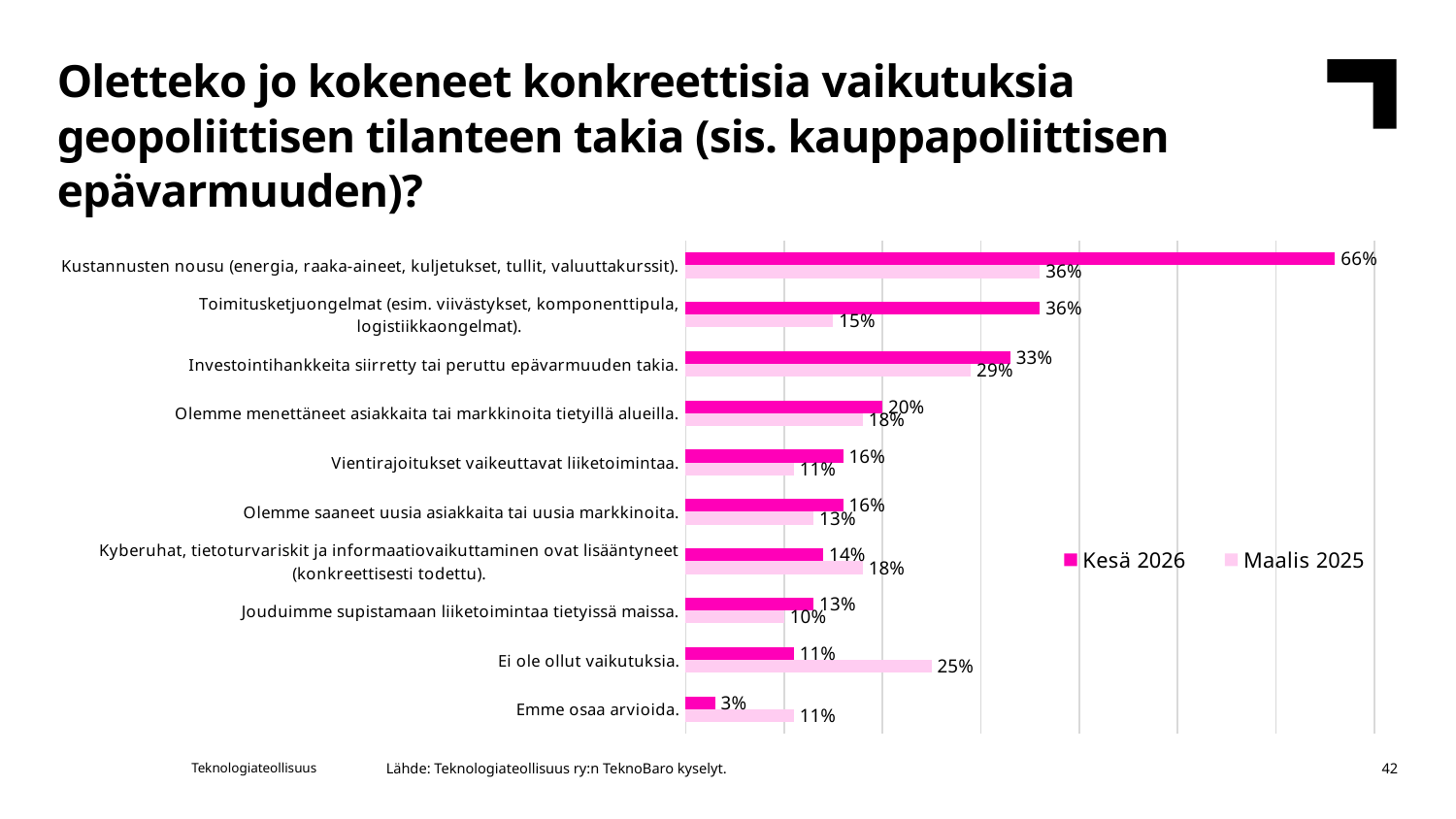
Which category has the lowest Kesä 2026 value? Emme osaa arvioida. What are the two series named in the legend? Kesä 2026 and Maalis 2025 What is the difference between the Kesä 2026 and Maalis 2025 values for "Toimitusketjuongelmat (esim. viivästykset, komponenttipula, logistiikkaongelmat)."? 21 percentage points What is the Maalis 2025 value for "Investointihankkeita siirretty tai peruttu epävarmuuden takia."? 29% What is the Maalis 2025 value for "Ei ole ollut vaikutuksia."? 25% What is the Kesä 2026 value for "Kustannusten nousu (energia, raaka-aineet, kuljetukset, tullit, valuuttakurssit)."? 66% What type of chart is shown on the slide? Bar chart How many series does the legend list? 2 For "Kyberuhat, tietoturvariskit ja informaatiovaikuttaminen ovat lisääntyneet (konkreettisesti todettu).", which series has the larger value, Kesä 2026 or Maalis 2025? Maalis 2025 Which category has the highest Kesä 2026 value? Kustannusten nousu (energia, raaka-aineet, kuljetukset, tullit, valuuttakurssit). What is the Kesä 2026 value for "Emme osaa arvioida."? 3% How many categories are shown in the chart? 10